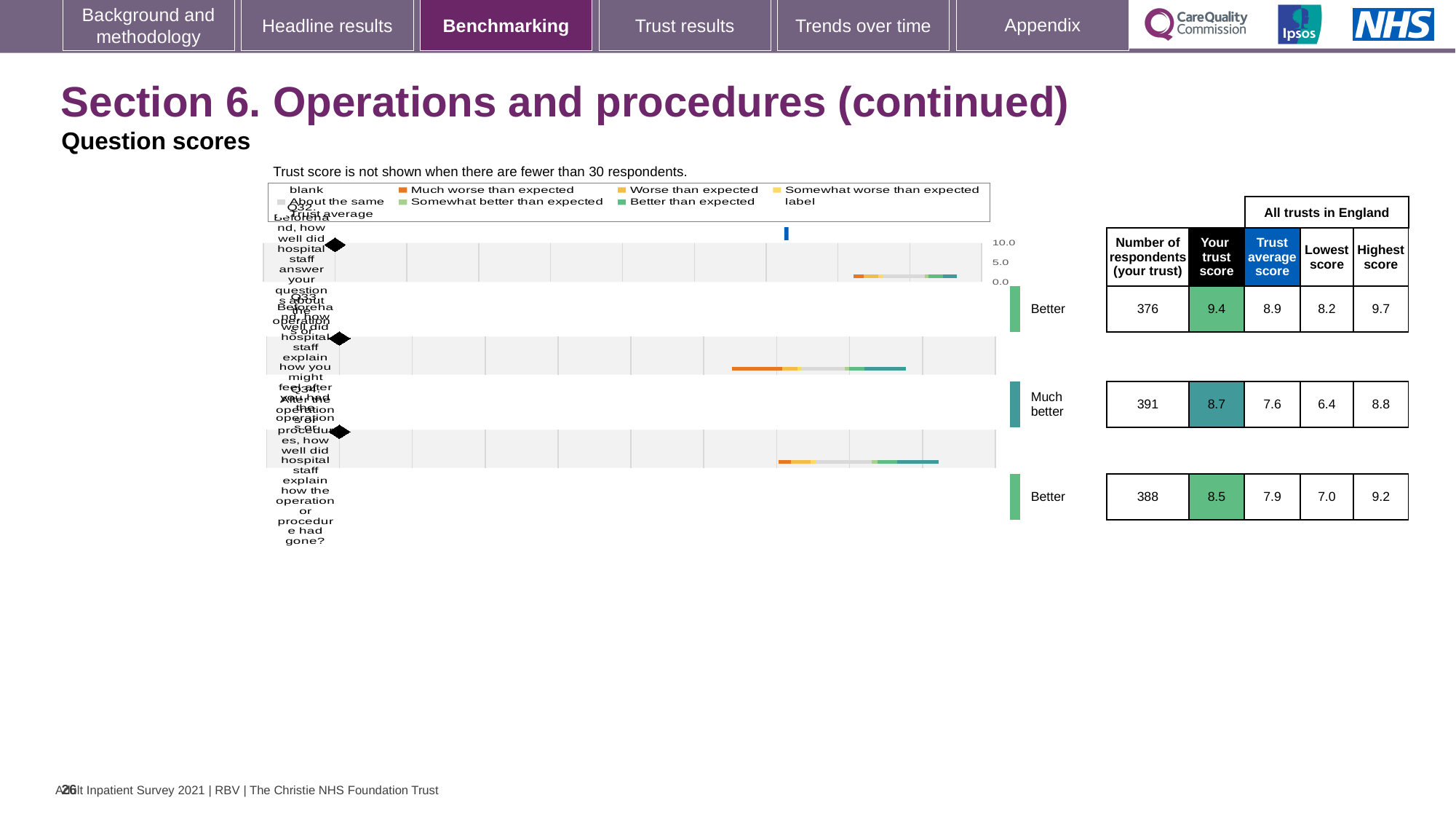
Which of the three questions has the highest 'Your trust score'? Q32 What is the trust average score for the second question (Q33)? 7.6 What is the highest score across all trusts in England for the third question (Q34)? 9.2 Is the trust score for the first question (Q32) larger or smaller than the trust score for the third question (Q34)? larger Which of the three questions has the lowest 'Lowest score' across all trusts in England? Q33 What is the maximum value shown on the chart's score axis? 10.0 What kind of chart is used to show the question scores on this slide? bar chart What is the trust score for the first question (Q32), as shown in the 'Your trust score' column? 9.4 What is the difference between the trust score and the trust average score for the second question (Q33)? 1.1 What rating label is shown next to the second question (Q33)? Much better How many questions (categories) are plotted in the chart? 3 How many respondents answered the second question (Q33) at this trust? 391